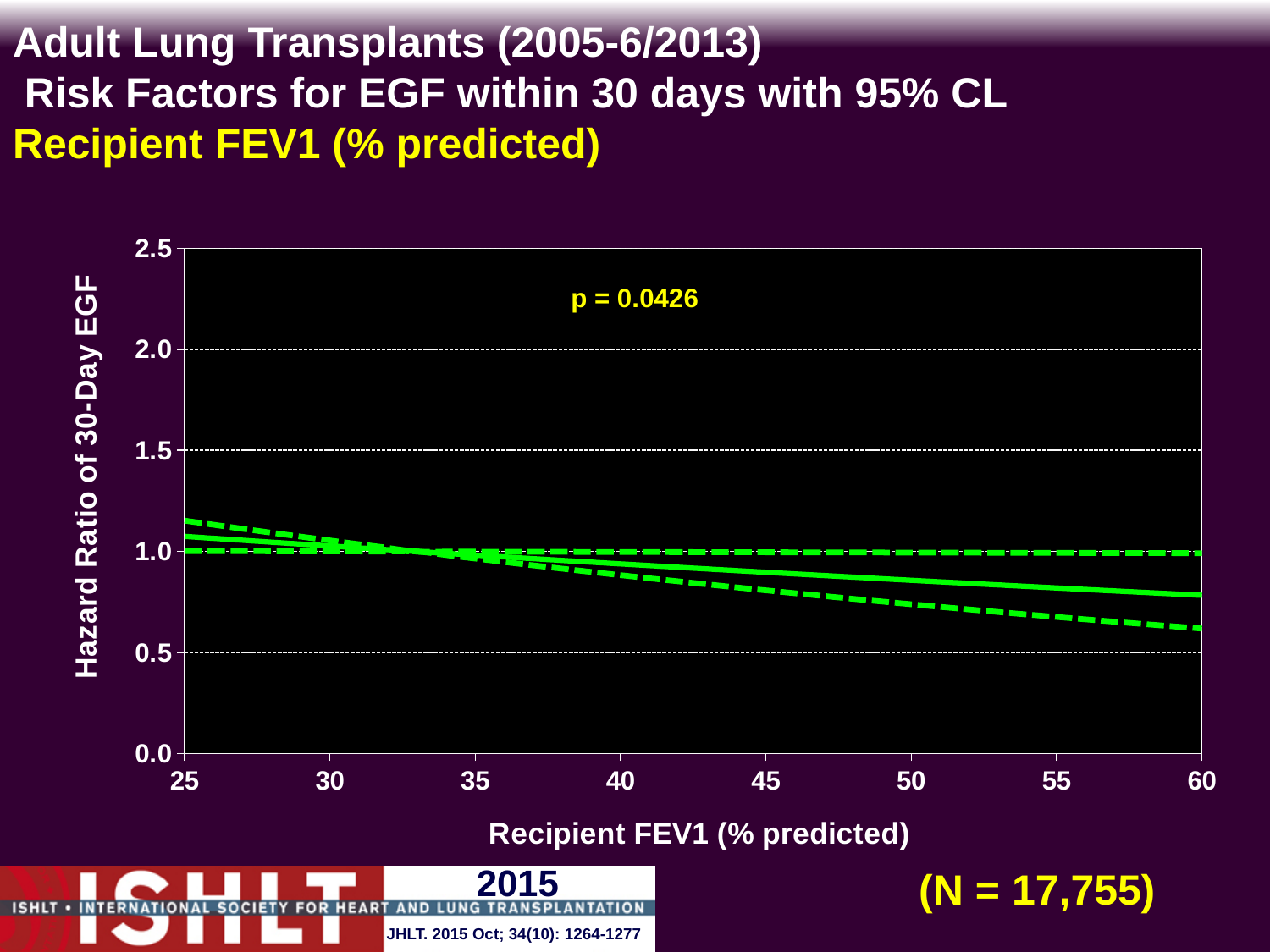
Does the solid hazard ratio line rise or fall as Recipient FEV1 (% predicted) increases from 25 to 60? fall What kind of chart is shown on the slide? line chart Is the lower 95% confidence limit (lower dashed line) at a Recipient FEV1 of 60% predicted greater or less than 0.5? greater What p-value is printed on the chart? p = 0.0426 How many lines are plotted on the chart? 3 Is the upper 95% confidence limit (upper dashed line) at a Recipient FEV1 of 25% predicted greater or less than 1.5? less Is the hazard ratio (solid line) at a Recipient FEV1 of 60% predicted greater or less than 1.0? less What is the label of the y axis? Hazard Ratio of 30-Day EGF